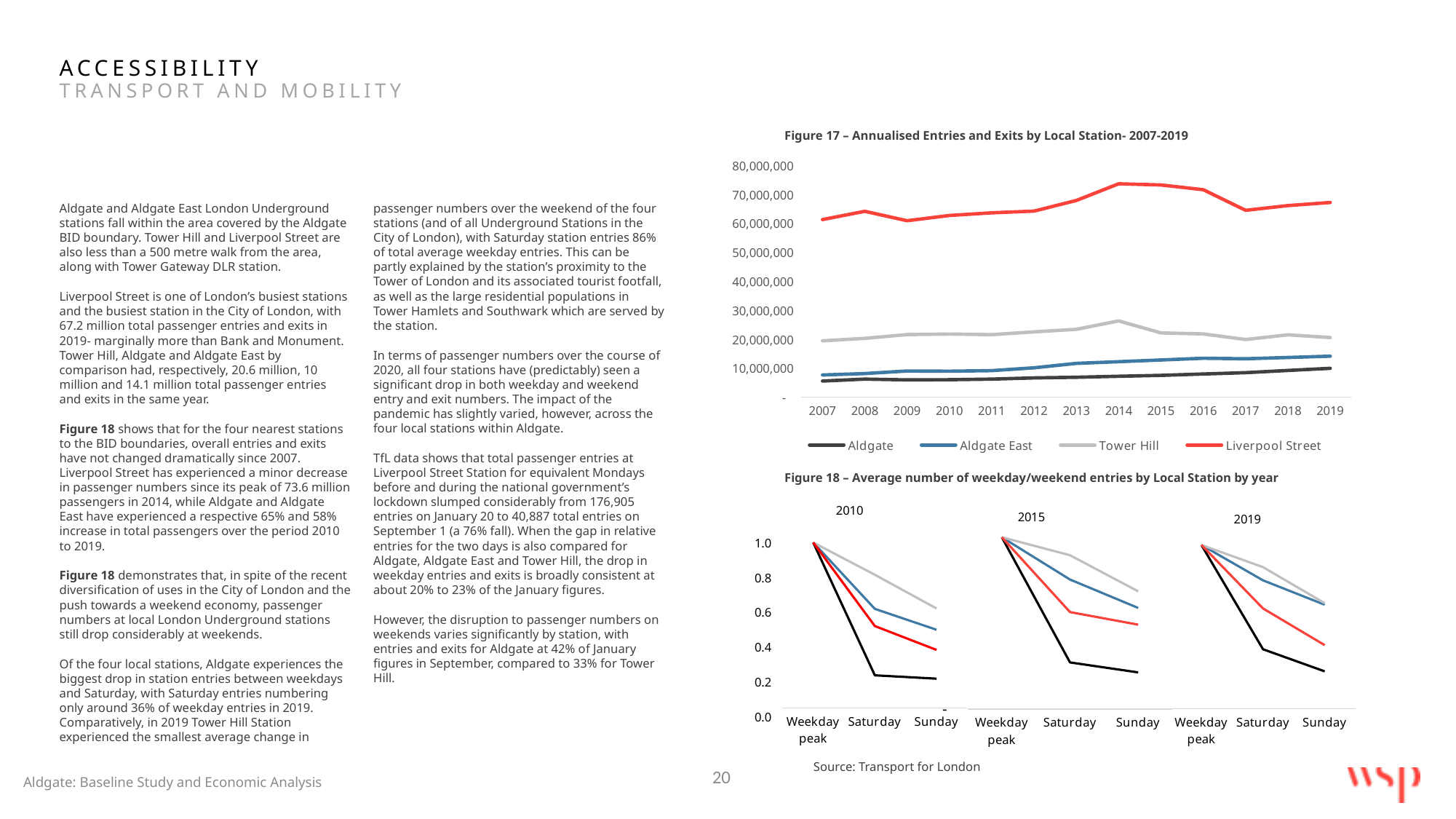
In Figure 17, is the value for Liverpool Street in 2014 greater or less than 70,000,000? greater In Figure 17, does the Aldgate East line rise or fall from 2007 to 2019? Rise In Figure 17, in which year does the Liverpool Street line reach its peak? 2014 In Figure 17, which is larger in 2019: Tower Hill or Aldgate East? Tower Hill In Figure 17, is the value for Tower Hill in 2017 greater or less than 30,000,000? less How many series does the legend of Figure 17 list? 4 In Figure 18, which three years are shown as separate panels? 2010, 2015, 2019 What kind of chart is Figure 17 – Annualised Entries and Exits by Local Station? Line chart In Figure 17, which station has the lowest annualised entries and exits across the whole period? Aldgate In Figure 17, is the value for Aldgate East in 2019 greater or less than 10,000,000? greater How many years are shown on the x axis of Figure 17? 13 In Figure 17, which station has the highest annualised entries and exits across the whole period? Liverpool Street